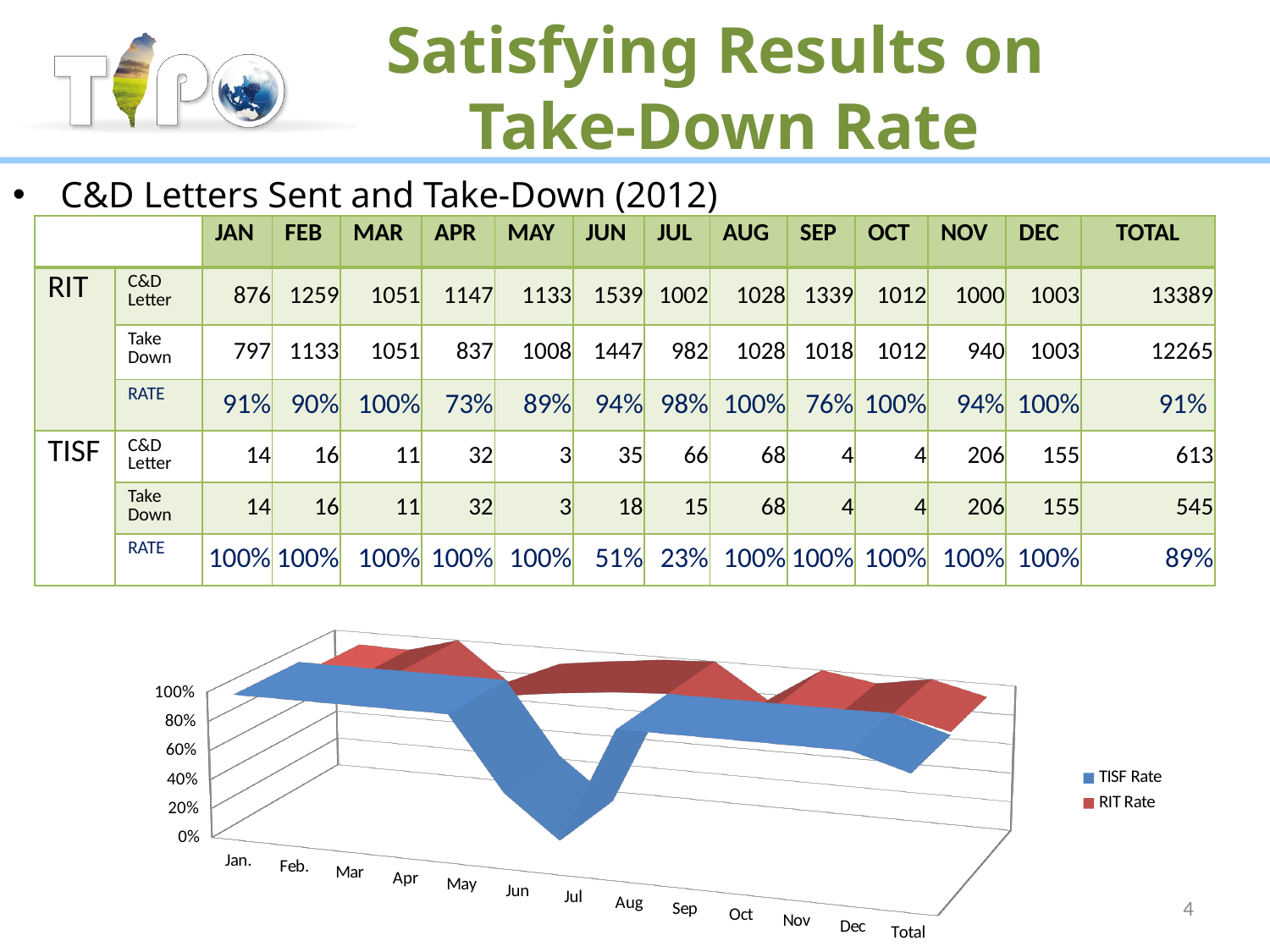
What are the two series named in the chart's legend? TISF Rate and RIT Rate How many categories are plotted along the x axis of the chart? 13 For Jun, which is larger, the TISF Rate or the RIT Rate? RIT Rate In which month is the TISF Rate lowest? Jul What kind of chart is shown at the bottom of the slide? 3D line chart In which month is the RIT Rate lowest? Apr Is the TISF Rate for Jul greater or less than 40%? less What is the difference between the RIT Rate Total and the TISF Rate Total? 2 percentage points How many series does the chart's legend list? 2 What is the RIT Rate for Apr? 73% Which series is plotted in blue in the chart? TISF Rate What is the TISF Rate for Jul? 23%